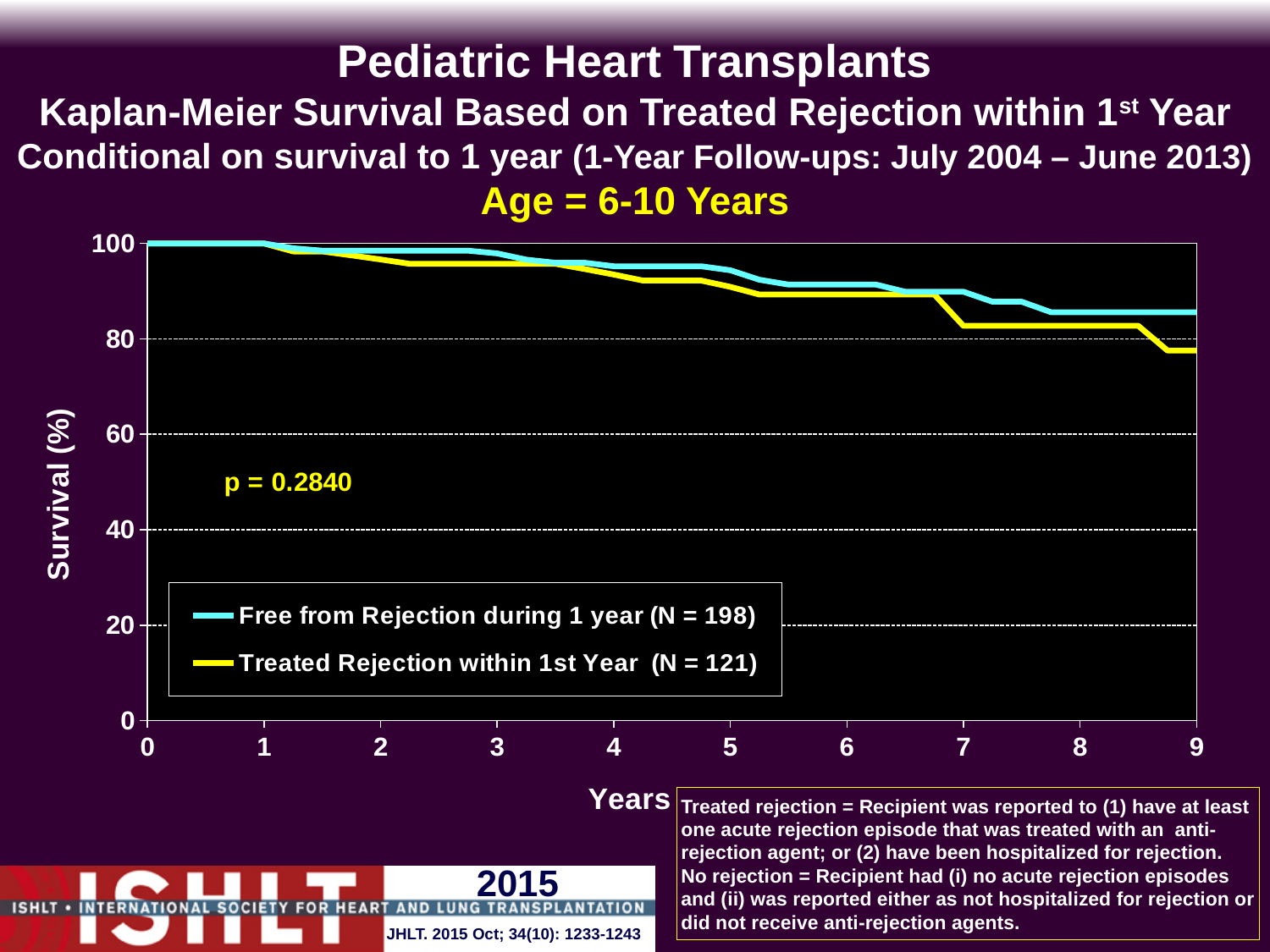
What is the N for the 'Free from Rejection during 1 year' group shown in the legend? 198 Is the survival value for the 'Treated Rejection within 1st Year' group at 9 years greater or less than 80? less Is the survival value for the 'Free from Rejection during 1 year' group at 9 years greater or less than 80? greater Is the survival value for the 'Treated Rejection within 1st Year' group at 3 years greater or less than 80? greater How many series does the legend list? 2 What kind of chart is shown on the slide? Line chart At 9 years, which group has the higher survival: 'Free from Rejection during 1 year' or 'Treated Rejection within 1st Year'? Free from Rejection during 1 year What p-value is printed on the chart? p = 0.2840 What is the label of the y axis? Survival (%) Do the survival curves rise or fall as years increase along the x axis? Fall What is the highest value labelled on the x axis (Years)? 9